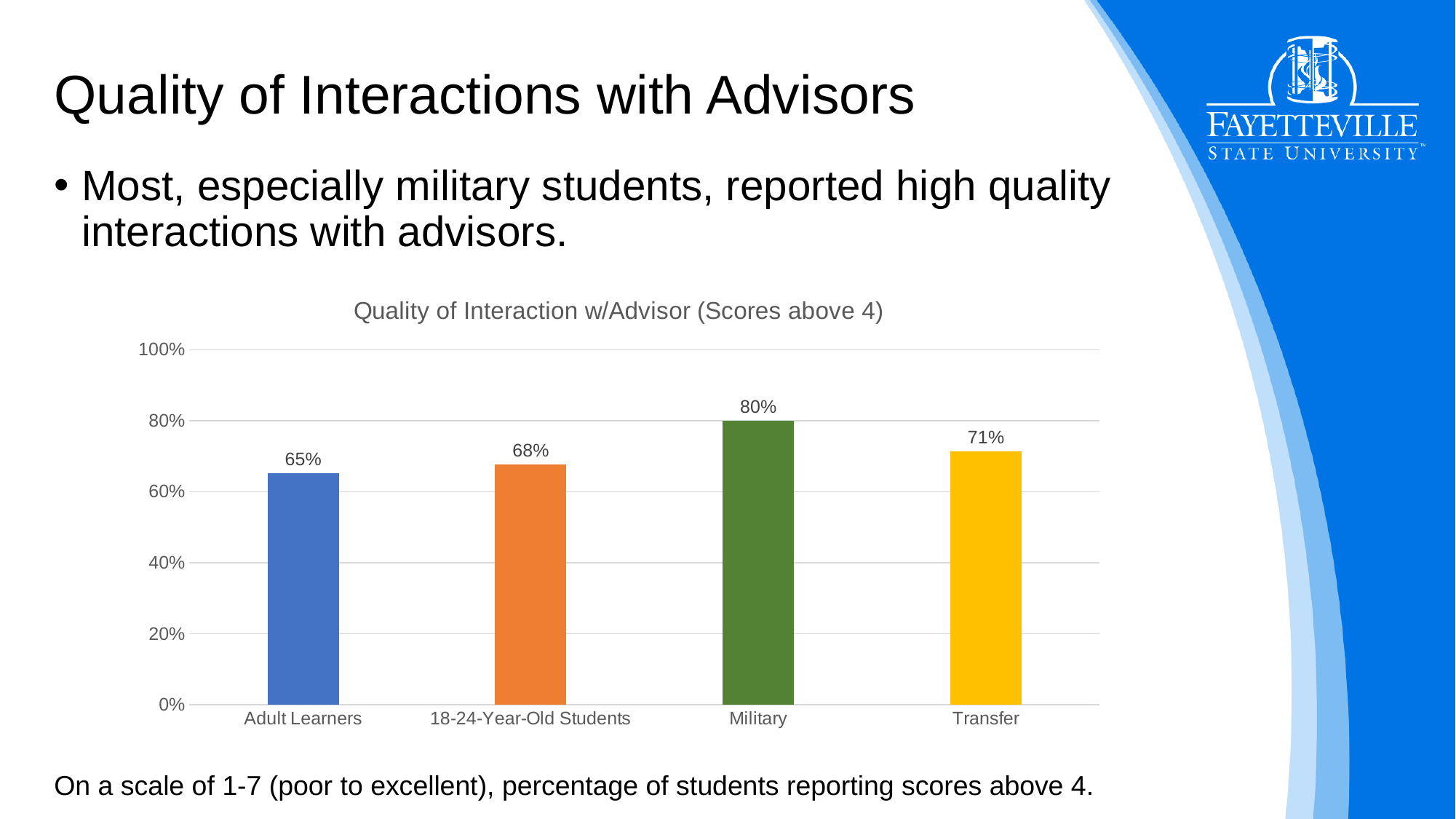
What is the difference between the values for Military and Adult Learners? 15% What is the difference between the values for Transfer and 18-24-Year-Old Students? 3% How many categories are shown in the chart? 4 What is the value for Military? 80% Which category has the lowest value? Adult Learners What is the value for 18-24-Year-Old Students? 68% Which is larger, the value for Transfer or the value for Adult Learners? Transfer What kind of chart is shown on the slide? Bar chart Which category has the highest value? Military What is the value for Transfer? 71% What is the title of the chart? Quality of Interaction w/Advisor (Scores above 4) What is the value for Adult Learners? 65%